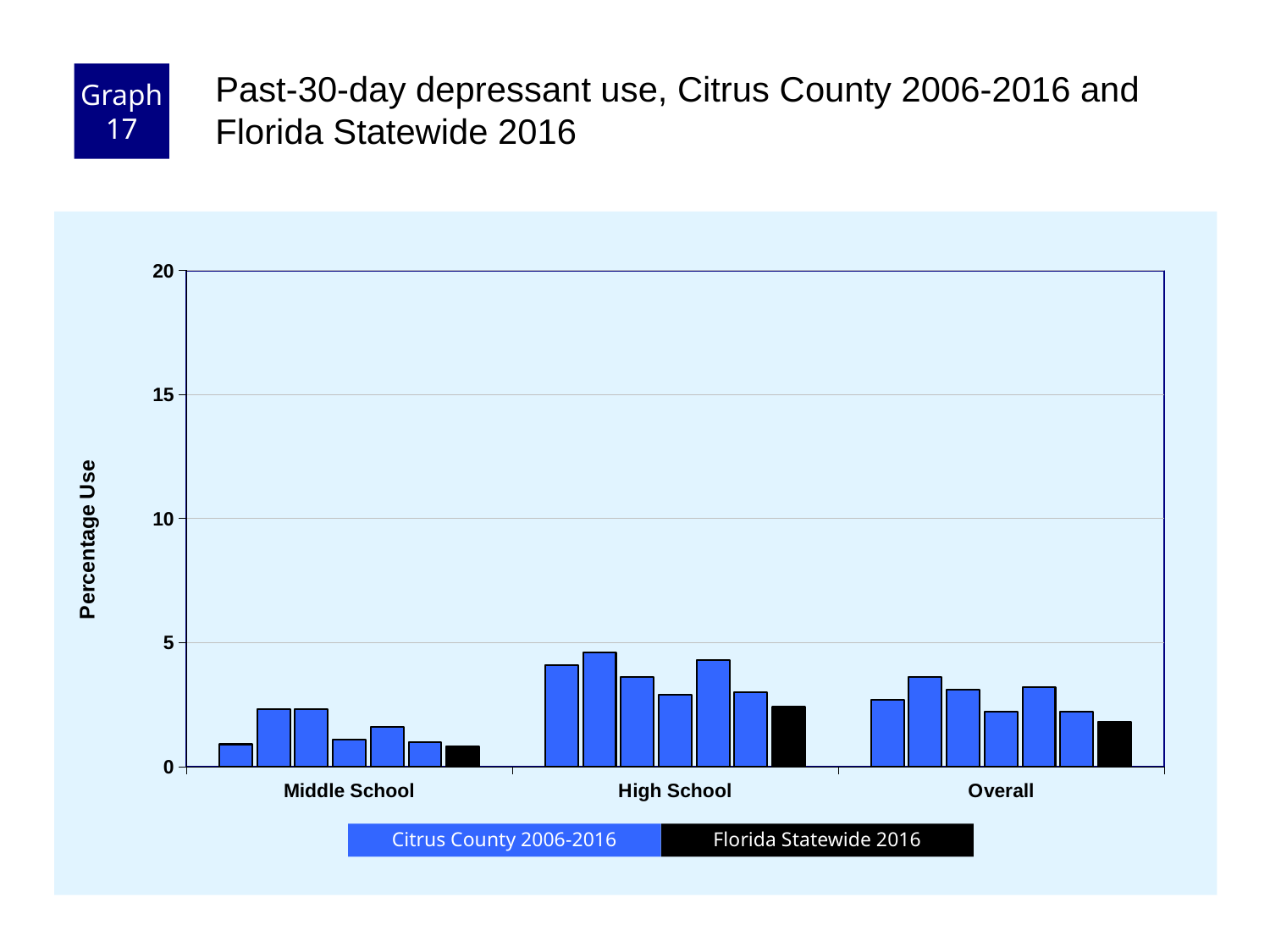
What is the title of the chart? Past-30-day depressant use, Citrus County 2006-2016 and Florida Statewide 2016 How many categories are shown on the x axis? 3 What kind of chart is shown on the slide? Bar chart Are any of the bars in the Overall group greater or less than 10? less Is the Florida Statewide 2016 value for High School greater or less than 5? less How many bars are shown in the Middle School group? 7 Which category has the lowest Florida Statewide 2016 value? Middle School Which is larger, the Florida Statewide 2016 value for High School or for Overall? High School Which category has the highest Florida Statewide 2016 value? High School Is the Florida Statewide 2016 value for Middle School greater or less than 5? less What is the label on the y axis? Percentage Use How many series does the legend list? 2